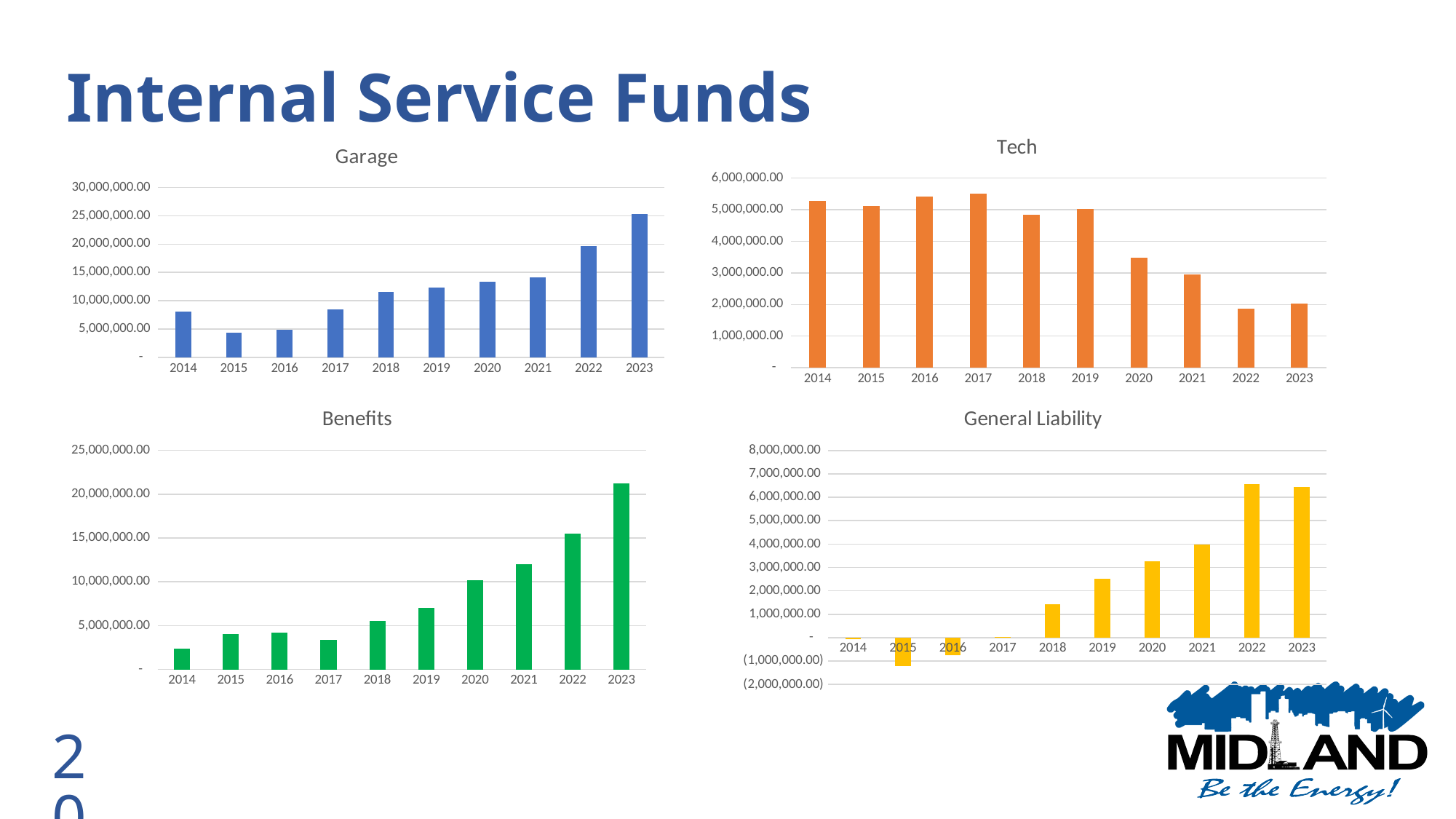
In the Tech chart, do the values generally rise or fall from 2014 to 2023? Fall In the Garage chart, which year has the highest value? 2023 What colour are the bars in the Benefits chart? Green How many charts are on the slide? 4 In the Garage chart, which is larger, the value for 2014 or the value for 2015? 2014 How many years are shown on the x axis of the Tech chart? 10 In the General Liability chart, which year has the lowest value? 2015 In the Tech chart, is the value for 2020 greater or less than 3,000,000.00? greater What kind of chart is the Garage chart? Bar chart In the Benefits chart, which year has the lowest value? 2014 In the Garage chart, is the value for 2022 greater or less than 15,000,000.00? greater In the Benefits chart, is the value for 2023 greater or less than 20,000,000.00? greater